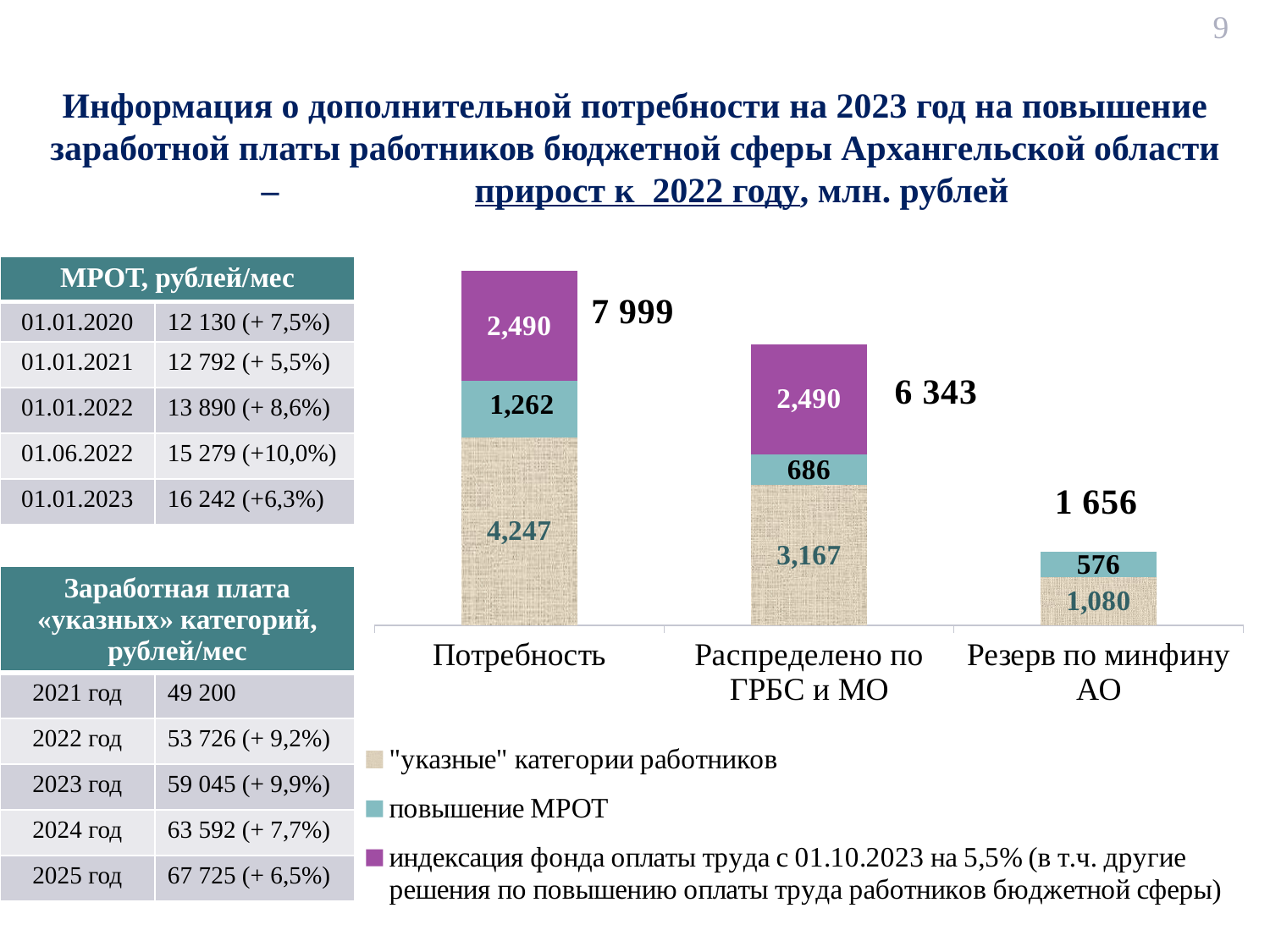
Which is larger: the "указные" категории работников segment for Потребность or for Распределено по ГРБС и МО? Потребность What is the difference between the повышение МРОТ values for Потребность and Распределено по ГРБС и МО? 576 What is the total shown above the Потребность bar? 7 999 What is the value of the "указные" категории работников segment for Потребность? 4,247 How many series does the chart legend list? 3 What is the value of the повышение МРОТ segment for Распределено по ГРБС и МО? 686 What is the total shown for Распределено по ГРБС и МО? 6 343 Which category has the lowest total? Резерв по минфину АО How many categories are shown on the x axis of the chart? 3 What is the value of the "указные" категории работников segment for Резерв по минфину АО? 1,080 What kind of chart is shown on the slide? stacked bar chart Which category has no индексация фонда оплаты труда segment? Резерв по минфину АО